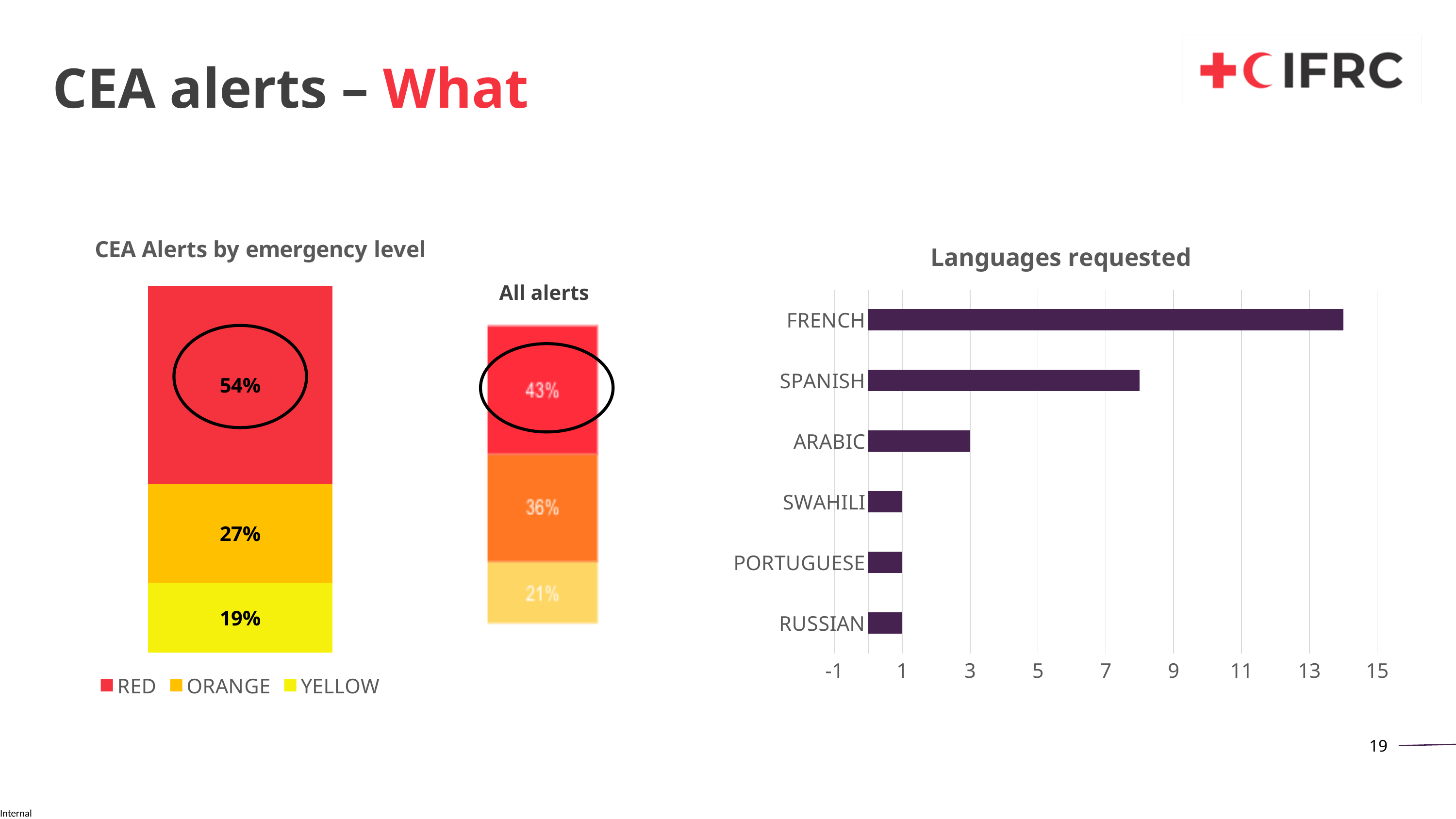
In the 'All alerts' bar, what percentage is shown for the orange segment? 36% In the 'CEA Alerts by emergency level' chart, which emergency level has the largest share? RED In the 'Languages requested' chart, how many languages are listed? 6 In the 'Languages requested' chart, which is larger, the value for SPANISH or the value for ARABIC? SPANISH In the 'Languages requested' chart, which language was requested most? FRENCH In the 'CEA Alerts by emergency level' chart, what percentage is shown for RED? 54% In the 'Languages requested' chart, is the value for FRENCH greater or less than 13? greater What kind of chart is 'Languages requested'? Bar chart In the 'CEA Alerts by emergency level' chart, what percentage is shown for YELLOW? 19% In the 'CEA Alerts by emergency level' chart, what is the difference between the RED and ORANGE percentages? 27% How many entries does the legend of the 'CEA Alerts by emergency level' chart list? 3 In the 'All alerts' bar, what percentage is shown for the red segment? 43%